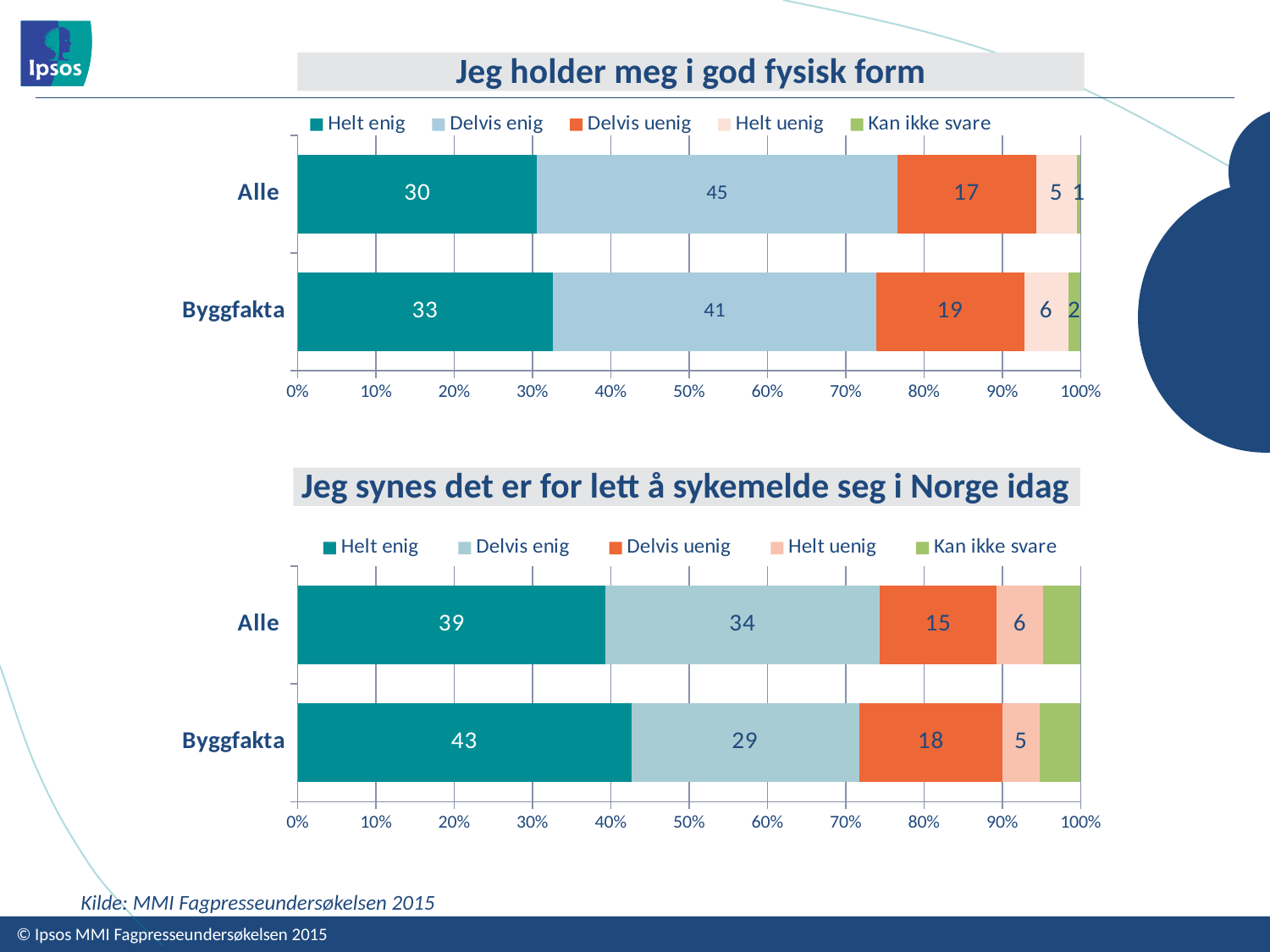
In the chart titled "Jeg synes det er for lett å sykemelde seg i Norge idag", which category has the larger Helt enig value, Alle or Byggfakta? Byggfakta In the chart titled "Jeg synes det er for lett å sykemelde seg i Norge idag", what is the value for Helt enig for Byggfakta? 43 In the chart titled "Jeg holder meg i god fysisk form", which series has the highest value for Alle? Delvis enig What kind of chart is the chart titled "Jeg synes det er for lett å sykemelde seg i Norge idag"? Stacked bar chart In the chart titled "Jeg holder meg i god fysisk form", what is the difference between the Delvis enig values for Alle and Byggfakta? 4 In the chart titled "Jeg synes det er for lett å sykemelde seg i Norge idag", how many series does the legend list? 5 In the chart titled "Jeg synes det er for lett å sykemelde seg i Norge idag", what is the difference between the Delvis uenig values for Byggfakta and Alle? 3 In the chart titled "Jeg holder meg i god fysisk form", what is the value for Delvis enig for Byggfakta? 41 In the chart titled "Jeg holder meg i god fysisk form", what is the value for Kan ikke svare for Byggfakta? 2 In the chart titled "Jeg holder meg i god fysisk form", what is the value for Helt enig for Alle? 30 In the chart titled "Jeg synes det er for lett å sykemelde seg i Norge idag", what is the value for Delvis uenig for Alle? 15 In the chart titled "Jeg holder meg i god fysisk form", how many categories are shown on the vertical axis? 2